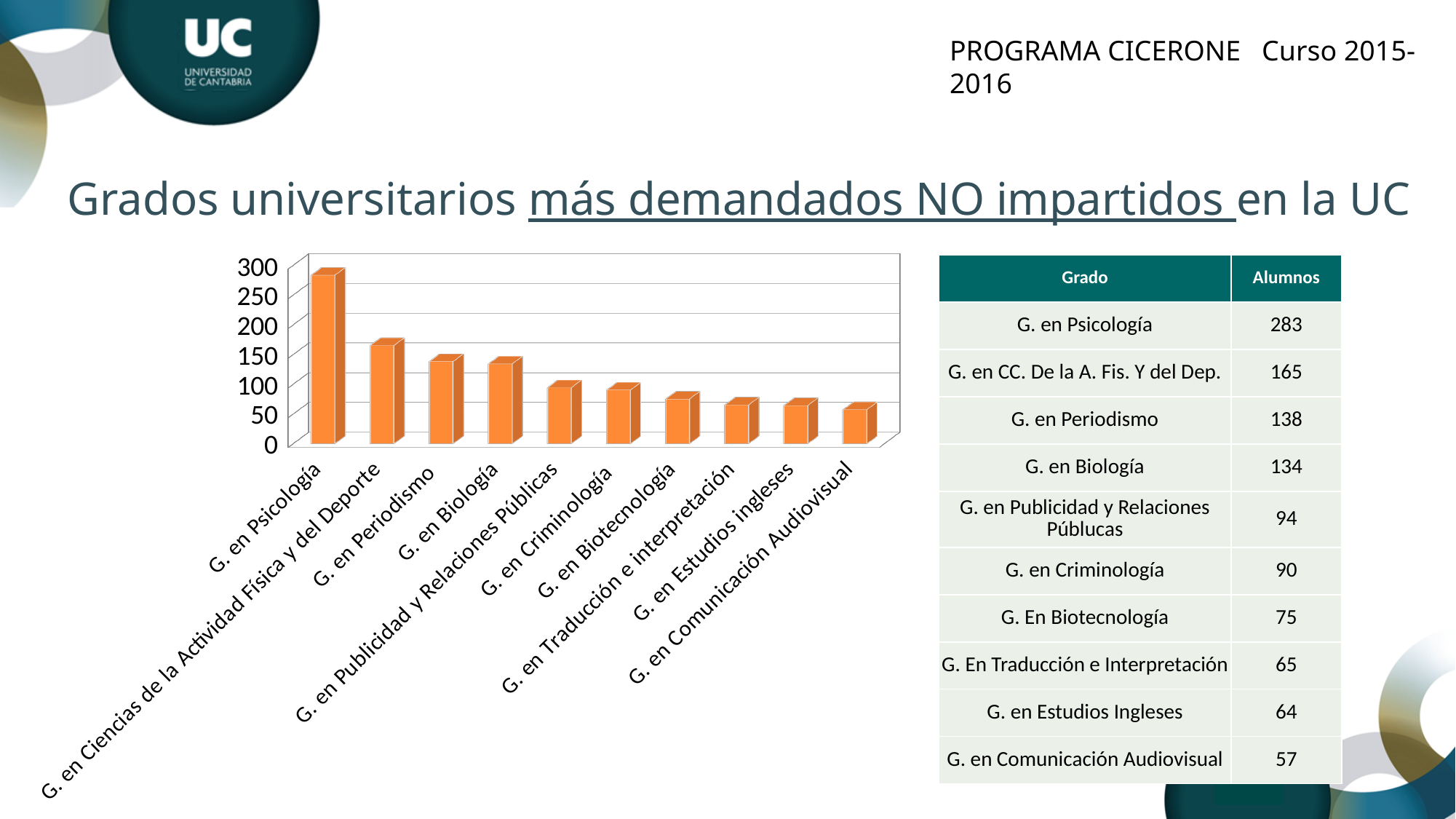
Is the value for G. en Criminología greater or less than 100? less Which degree has the highest bar in the chart? G. en Psicología Is the value for G. en Psicología greater or less than 250? greater What kind of chart is shown on the slide? bar chart How many degree categories are plotted in the chart? 10 According to the slide, how many students (Alumnos) are shown for G. en Comunicación Audiovisual? 57 What is the difference between the values for G. en Psicología (283) and G. en Periodismo (138) shown on the slide? 145 Which degree has the lowest bar in the chart? G. en Comunicación Audiovisual Is the value for G. en Periodismo greater or less than 100? greater Which is larger, the value for G. en Biología or the value for G. en Biotecnología? G. en Biología According to the slide, how many students (Alumnos) are shown for G. en Psicología? 283 Do the bar values rise or fall from left to right along the x axis? fall